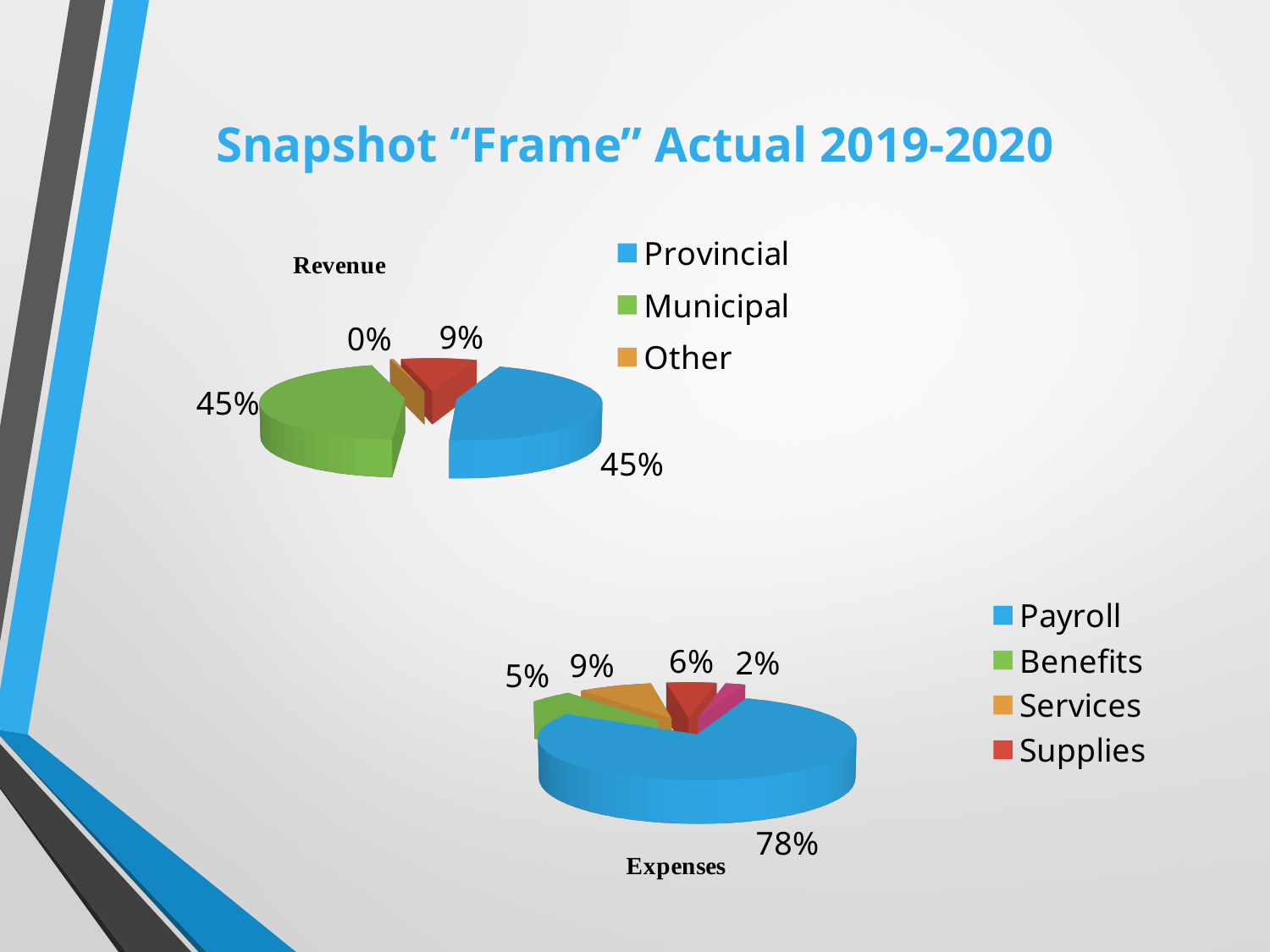
In the Expenses chart, what percentage is Payroll? 78% How many entries does the legend of the Expenses chart list? 4 In the Expenses chart, what is the difference between the Payroll share and the Services share? 69% In the Expenses chart, what percentage is Services? 9% In the Expenses chart, which is larger, Services or Benefits? Services What type of chart is the Revenue chart? Pie chart In the Revenue chart, what percentage is Other? 0% In the Expenses chart, what percentage is Benefits? 5% In the Expenses chart, what percentage is Supplies? 6% In the Revenue chart, which legend category has the smallest share? Other In the Revenue chart, what percentage is Provincial? 45% In the Expenses chart, which category has the largest share? Payroll